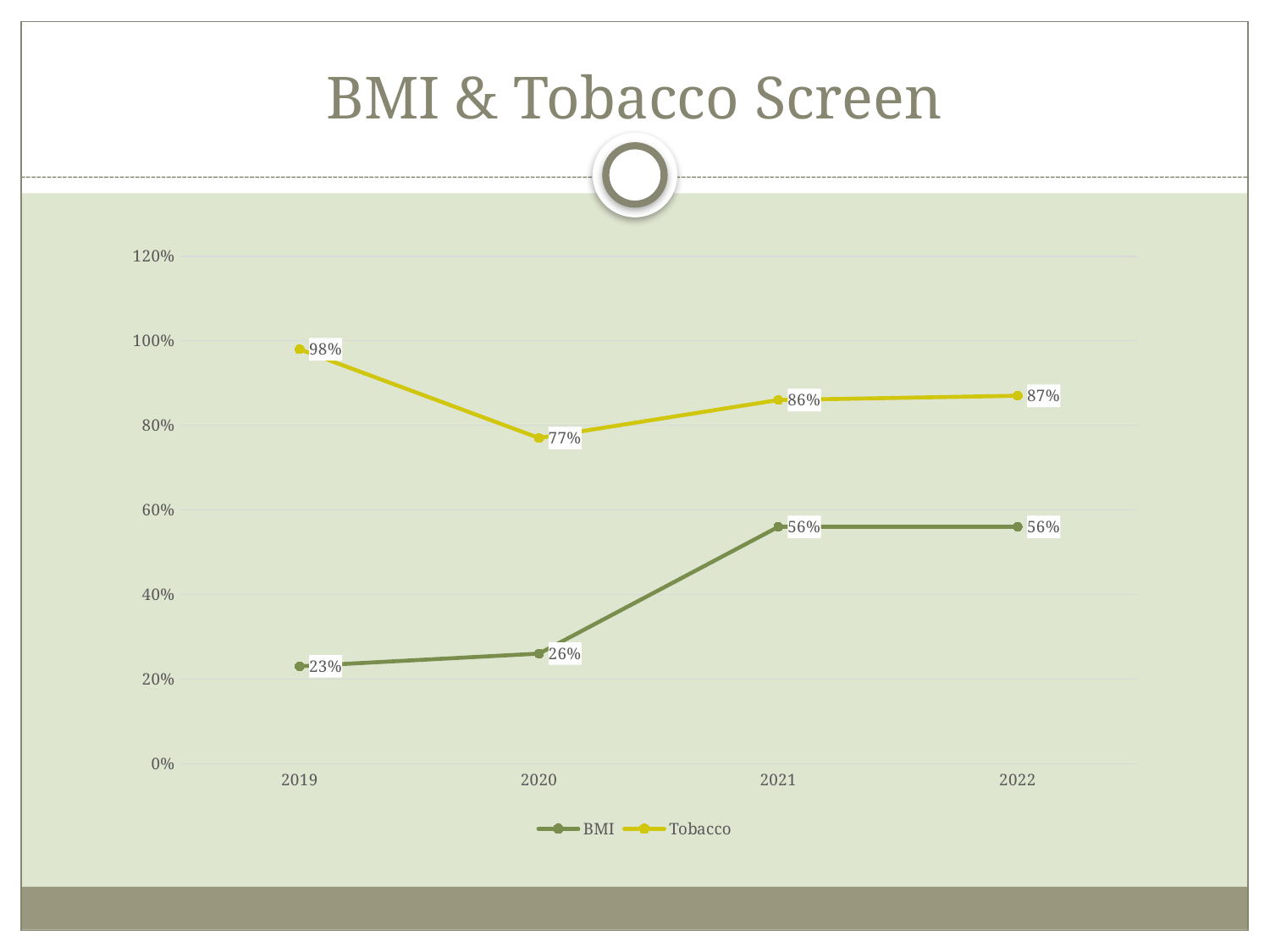
How many years are shown on the x axis? 4 In which year is the BMI series lowest? 2019 What is the BMI value for 2022? 56% In which year is the Tobacco series highest? 2019 How many series does the legend list? 2 What is the difference between the Tobacco and BMI values in 2021? 30% What is the Tobacco value for 2020? 77% What kind of chart is shown on the slide? Line chart Which is larger in 2020, the BMI value or the Tobacco value? Tobacco Does the BMI series rise or fall from 2019 to 2021? Rise What is the BMI value for 2019? 23% What is the title of the slide? BMI & Tobacco Screen